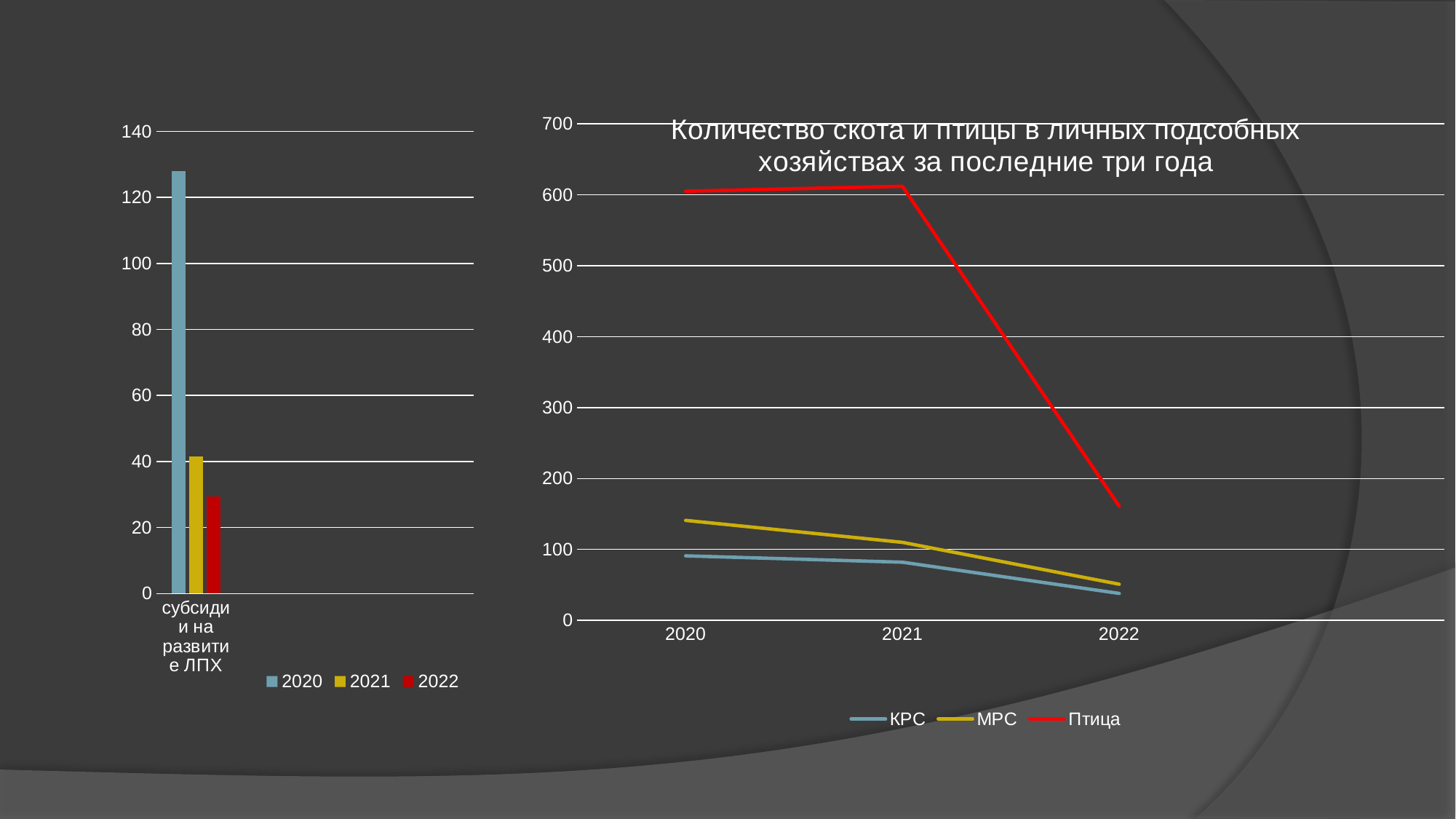
How many series does the legend of the right line chart list? 3 In the right line chart, is the value for Птица in 2020 greater or less than 500? greater What kind of chart is the chart titled "Количество скота и птицы в личных подсобных хозяйствах за последние три года"? line chart What kind of chart is the chart on the left side of the slide? bar chart In the left bar chart, which year has the highest bar for субсидии на развитие ЛПХ? 2020 In the right line chart, does the Птица series rise or fall from 2021 to 2022? fall How many series does the legend of the left bar chart list? 3 In the right line chart, how many years are shown on the x axis? 3 In the left bar chart, which year has the lowest bar for субсидии на развитие ЛПХ? 2022 In the left bar chart, is the value for 2022 greater or less than 40? less In the left bar chart, is the value for 2020 greater or less than 120? greater In the right line chart, which series has the highest values across all years? Птица